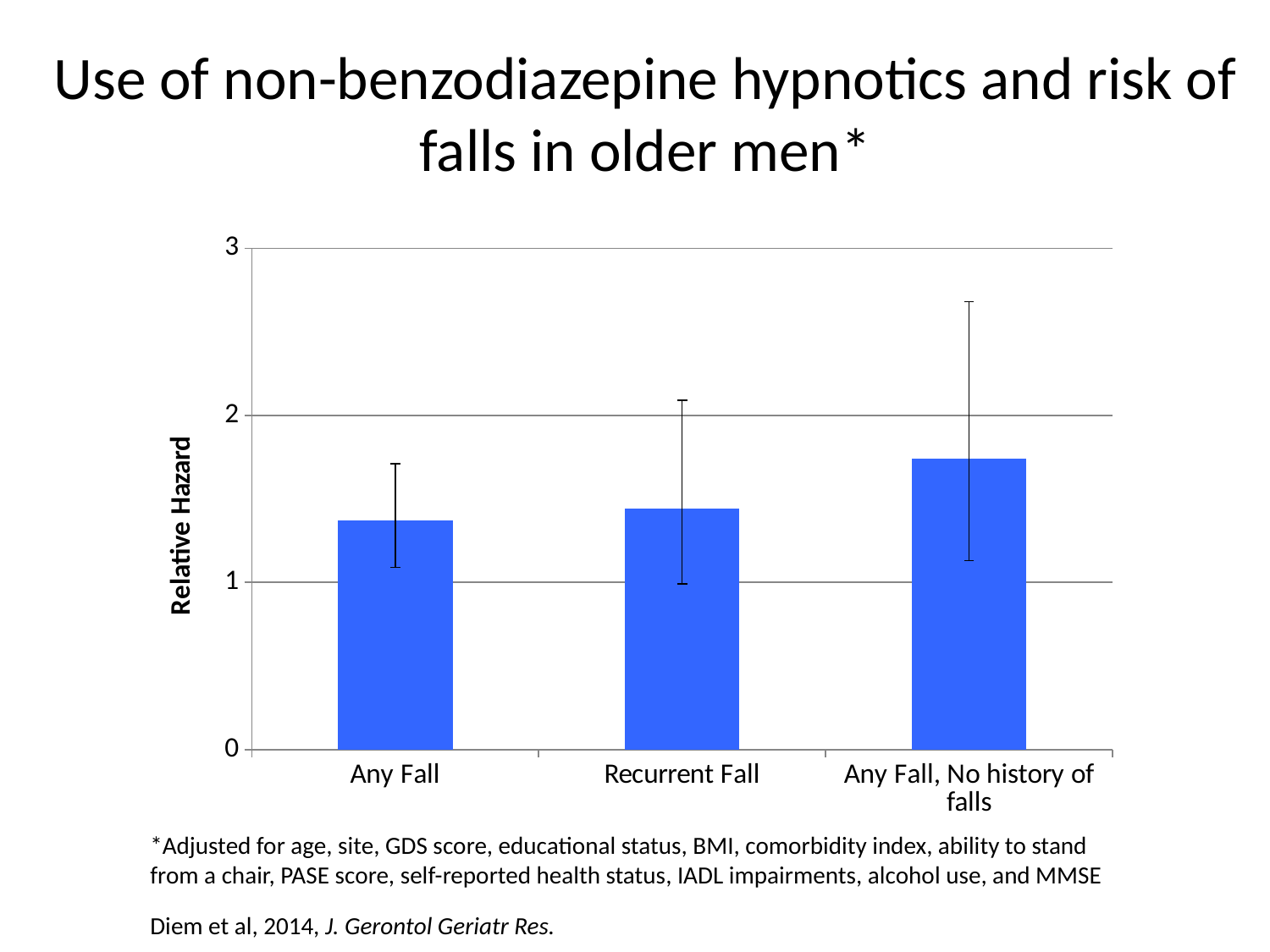
Is the relative hazard for Any Fall, No history of falls greater or less than 2? less What is the label of the vertical axis? Relative Hazard Which category has the highest relative hazard? Any Fall, No history of falls Do the bar values rise or fall from left to right across the x axis? rise How many categories are shown on the x axis of the chart? 3 Which has a larger relative hazard, Any Fall or Any Fall, No history of falls? Any Fall, No history of falls What kind of chart is shown on the slide? bar chart What is the highest value shown on the vertical axis? 3 Is the relative hazard for Any Fall greater or less than 1? greater Is the relative hazard for Any Fall, No history of falls greater or less than 1? greater